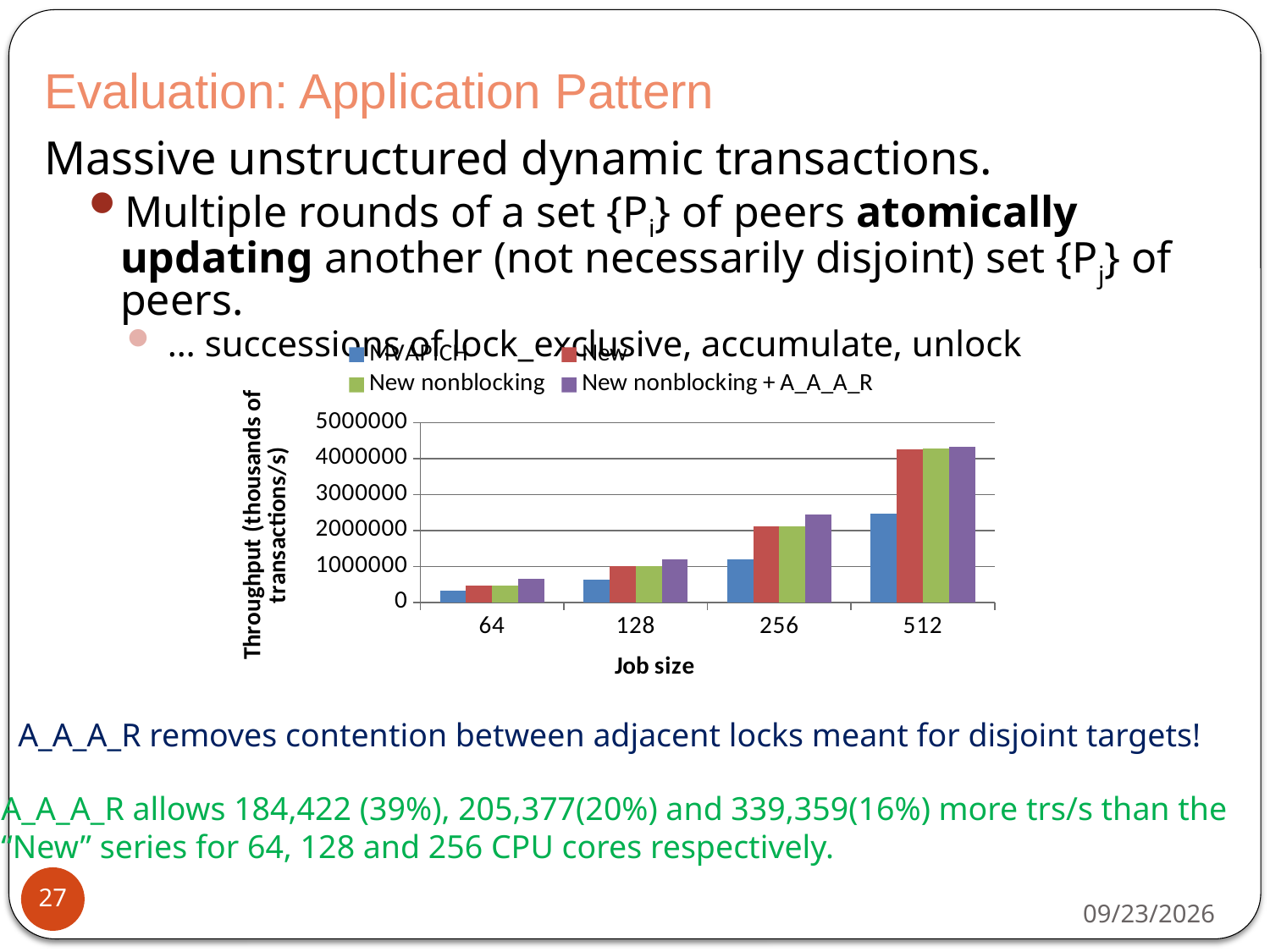
What is the title of the chart's vertical axis? Throughput (thousands of transactions/s) For which job size is the New nonblocking + A_A_A_R throughput lowest? 64 For which job size is the MVAPICH throughput highest? 512 Is the New value for job size 256 greater or less than 3000000? less How many series does the chart's legend list? 4 Is the MVAPICH value for job size 64 greater or less than 1000000? less Is the New nonblocking + A_A_A_R value for job size 512 greater or less than 4000000? greater What kind of chart is shown on the slide? bar chart At job size 256, which is larger: MVAPICH or New nonblocking + A_A_A_R? New nonblocking + A_A_A_R How many job sizes are shown on the x axis of the chart? 4 Does the MVAPICH throughput rise or fall as job size increases from 64 to 512? rise